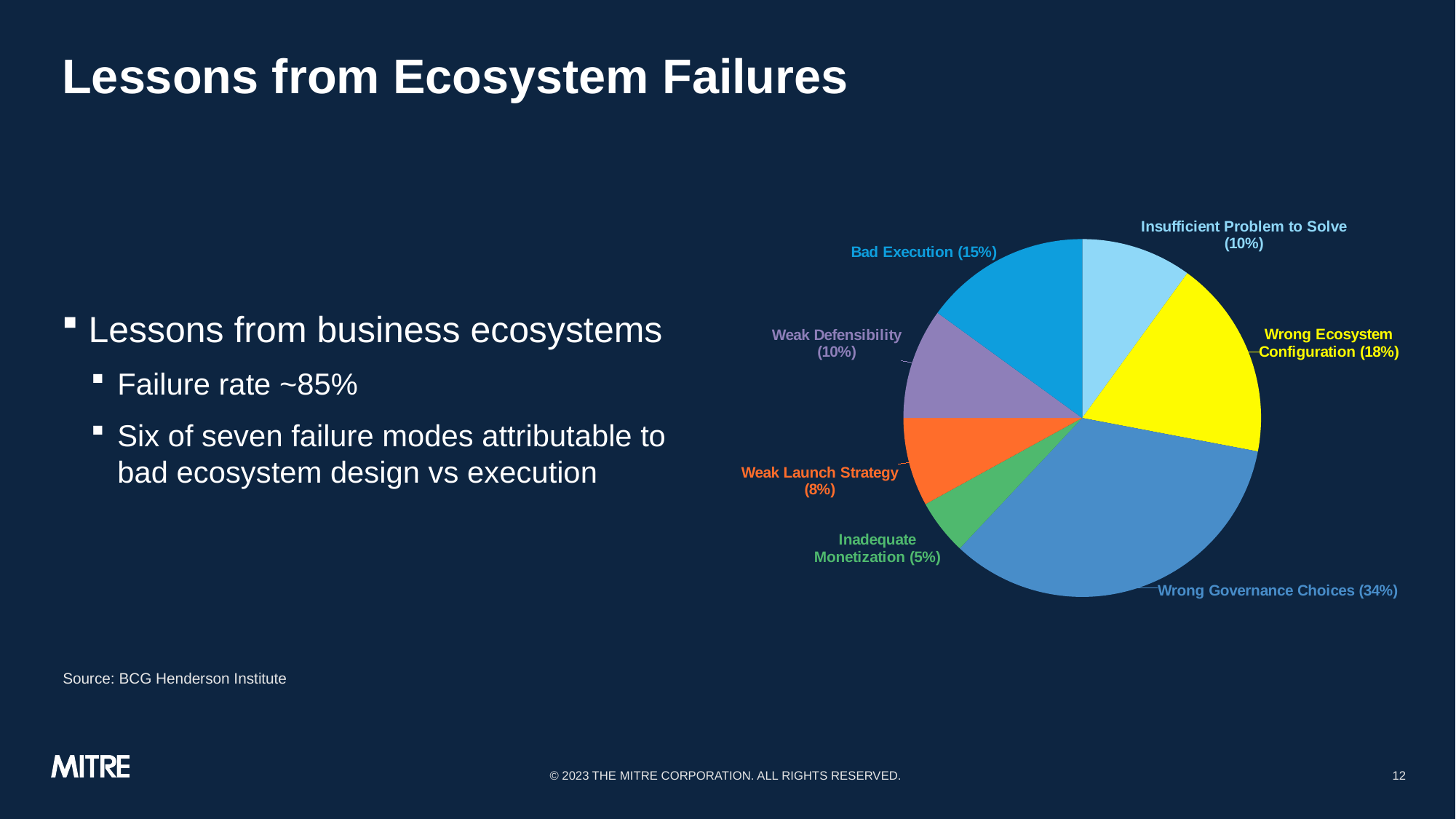
What share of the pie is Weak Launch Strategy? 8% How many slices does the pie chart have? 7 What share of the pie is Wrong Ecosystem Configuration? 18% What share of the pie is Wrong Governance Choices? 34% Which failure mode has the largest share of the pie? Wrong Governance Choices What colour is the Wrong Ecosystem Configuration slice? yellow Which is larger, Bad Execution or Weak Defensibility? Bad Execution What is the combined share of Insufficient Problem to Solve and Weak Defensibility? 20% What is the difference in percentage points between Wrong Governance Choices and Wrong Ecosystem Configuration? 16 Which failure mode has the smallest share of the pie? Inadequate Monetization What kind of chart is shown on the slide? pie chart